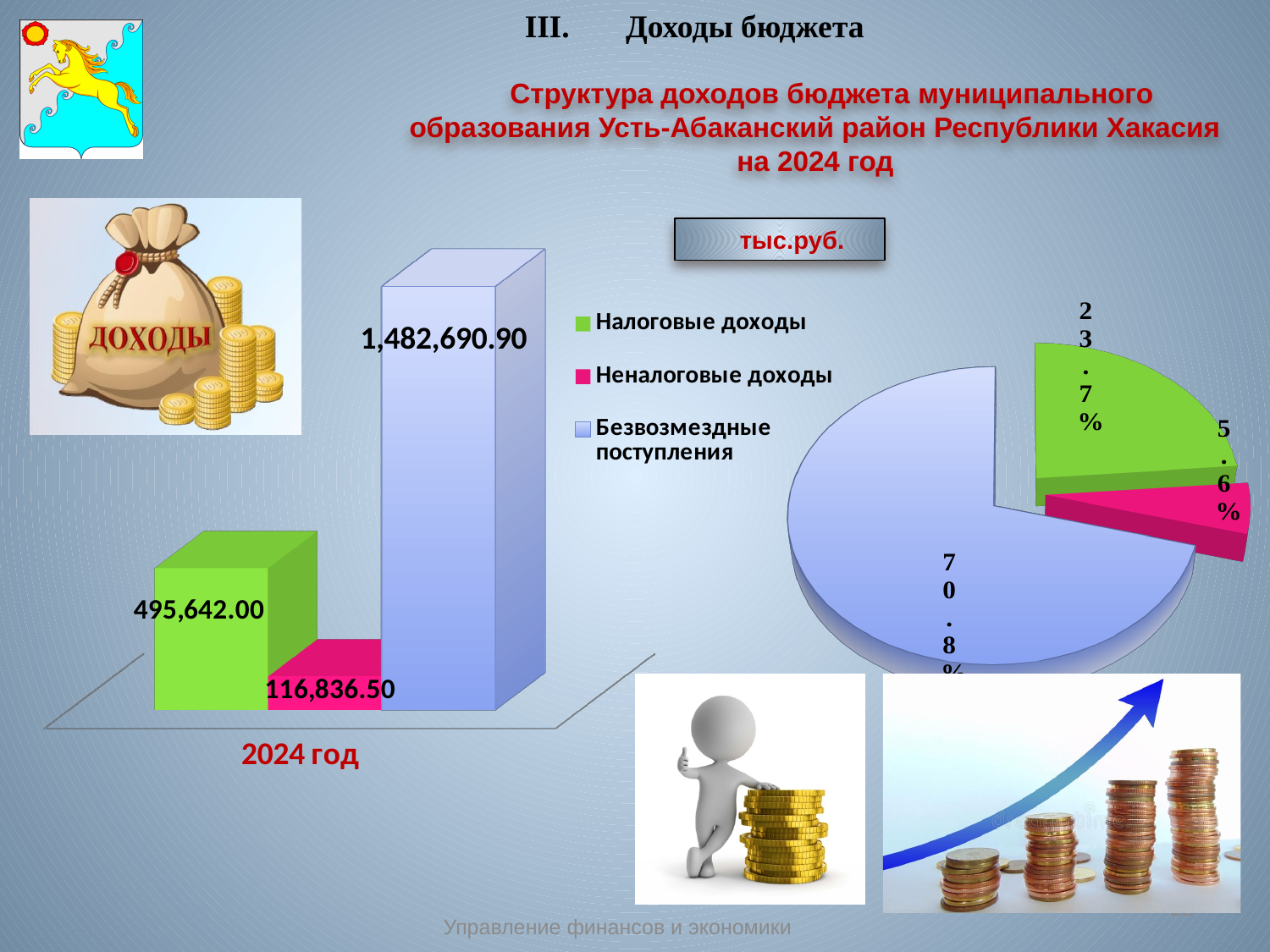
What unit is shown in the box above the charts? тыс.руб. On the bar chart, what is the value for Неналоговые доходы? 116,836.50 On the bar chart, what is the value for Налоговые доходы? 495,642.00 How many series does the legend of the bar chart list? 3 On the bar chart, which is larger: Налоговые доходы or Безвозмездные поступления? Безвозмездные поступления On the bar chart, what is the value for Безвозмездные поступления? 1,482,690.90 On the pie chart, what share does the green slice (Налоговые доходы) have? 23.7% On the pie chart, what share does the pink slice (Неналоговые доходы) have? 5.6% On the bar chart, what is the difference between Налоговые доходы and Неналоговые доходы? 378,805.50 What kind of chart is the chart on the left with the 2024 год label? Bar chart On the bar chart, which series has the lowest value? Неналоговые доходы On the bar chart, which series has the highest value? Безвозмездные поступления